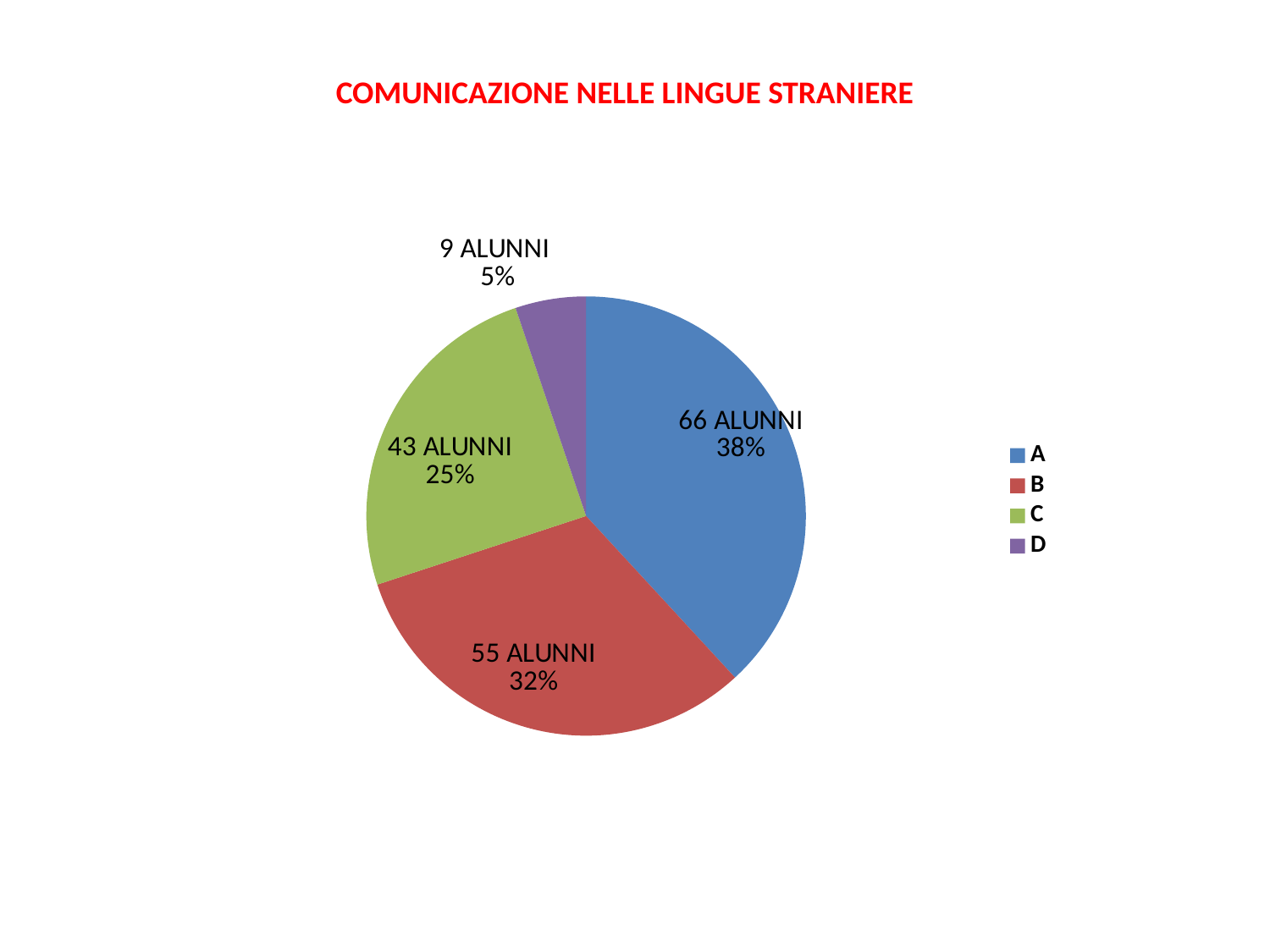
What percentage share does category D have? 5% Which category has the smallest slice? D How many students (alunni) are in category A? 66 ALUNNI What colour is the slice for category C? green Which category has the largest slice? A What is the title of the chart? COMUNICAZIONE NELLE LINGUE STRANIERE How many categories does the pie chart have? 4 What kind of chart is shown on the slide? pie chart Which category has more students, C or D? C What percentage share does category B have? 32% How many students are in category C? 43 ALUNNI How many more students are in category A than in category B? 11